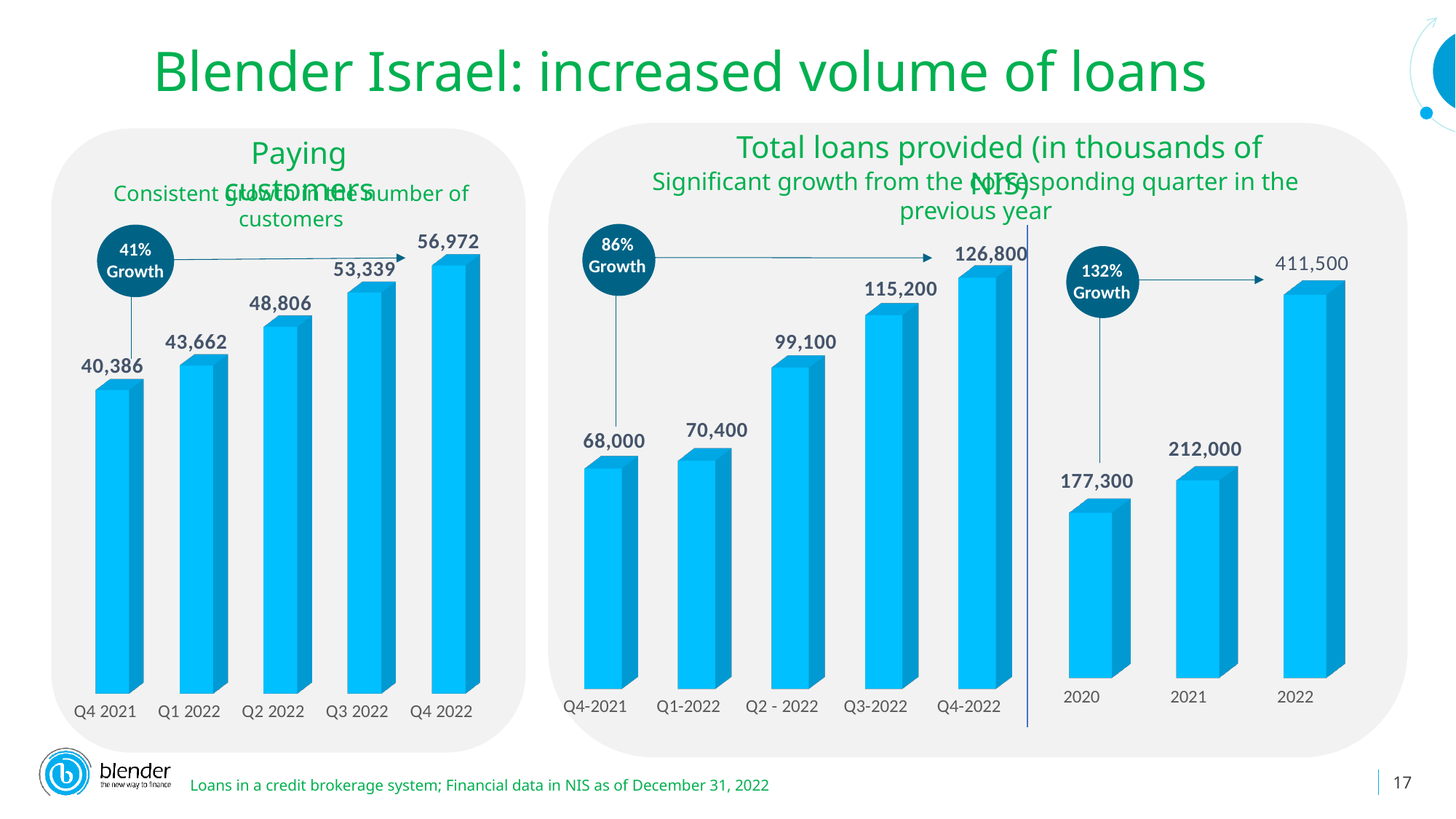
On the annual Total loans provided chart (2020–2022), what is the difference between 2022 and 2021? 199,500 On the Paying customers chart, which quarter has the lowest value? Q4 2021 On the Paying customers chart, do the values rise or fall from Q4 2021 to Q4 2022? rise On the Paying customers chart, what is the value for Q2 2022? 48,806 On the Paying customers chart, how many quarters are shown? 5 On the quarterly Total loans provided chart, what is the difference between Q4-2022 and Q4-2021? 58,800 On the Paying customers chart, what is the difference between Q4 2022 and Q4 2021? 16,586 On the Paying customers chart, what is the value for Q4 2022? 56,972 On the quarterly Total loans provided chart, what is the value for Q2 - 2022? 99,100 What type of chart is the Paying customers chart? bar chart On the annual Total loans provided chart (2020–2022), what is the value for 2021? 212,000 On the quarterly Total loans provided chart, which quarter has the highest value? Q4-2022